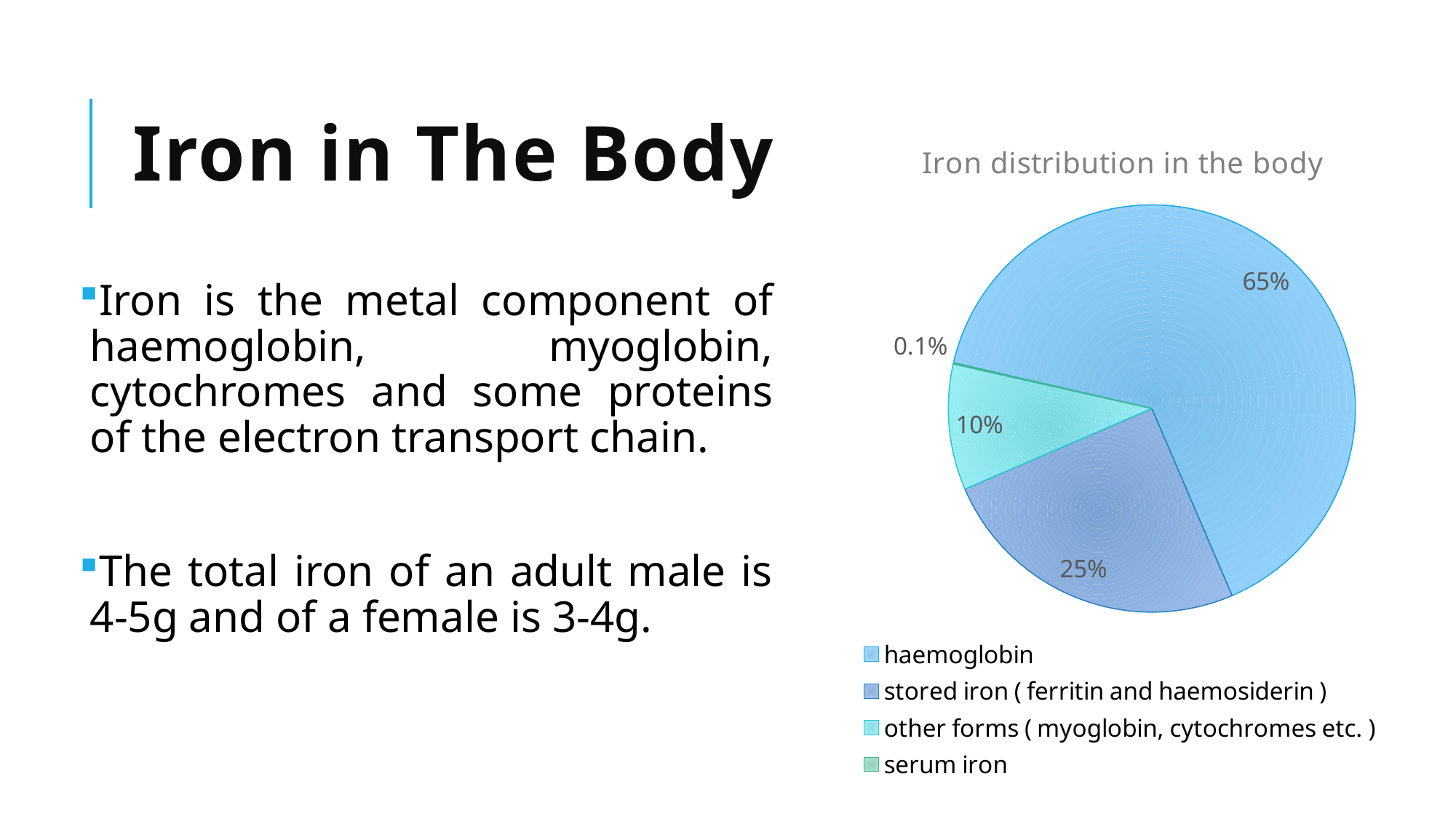
Which is larger, the share for stored iron or the share for other forms? stored iron Which category is shown in green in the legend? serum iron What is the title of the chart? Iron distribution in the body What percentage of iron is serum iron? 0.1% What kind of chart is shown on the slide? pie chart What is the difference between the haemoglobin share and the stored iron share? 40% What percentage of iron is in other forms (myoglobin, cytochromes etc.)? 10% What percentage of iron in the body is in haemoglobin? 65% How many categories does the legend list? 4 What percentage of iron is stored iron (ferritin and haemosiderin)? 25% Which category has the smallest share of the pie? serum iron Which category has the largest share of the pie? haemoglobin